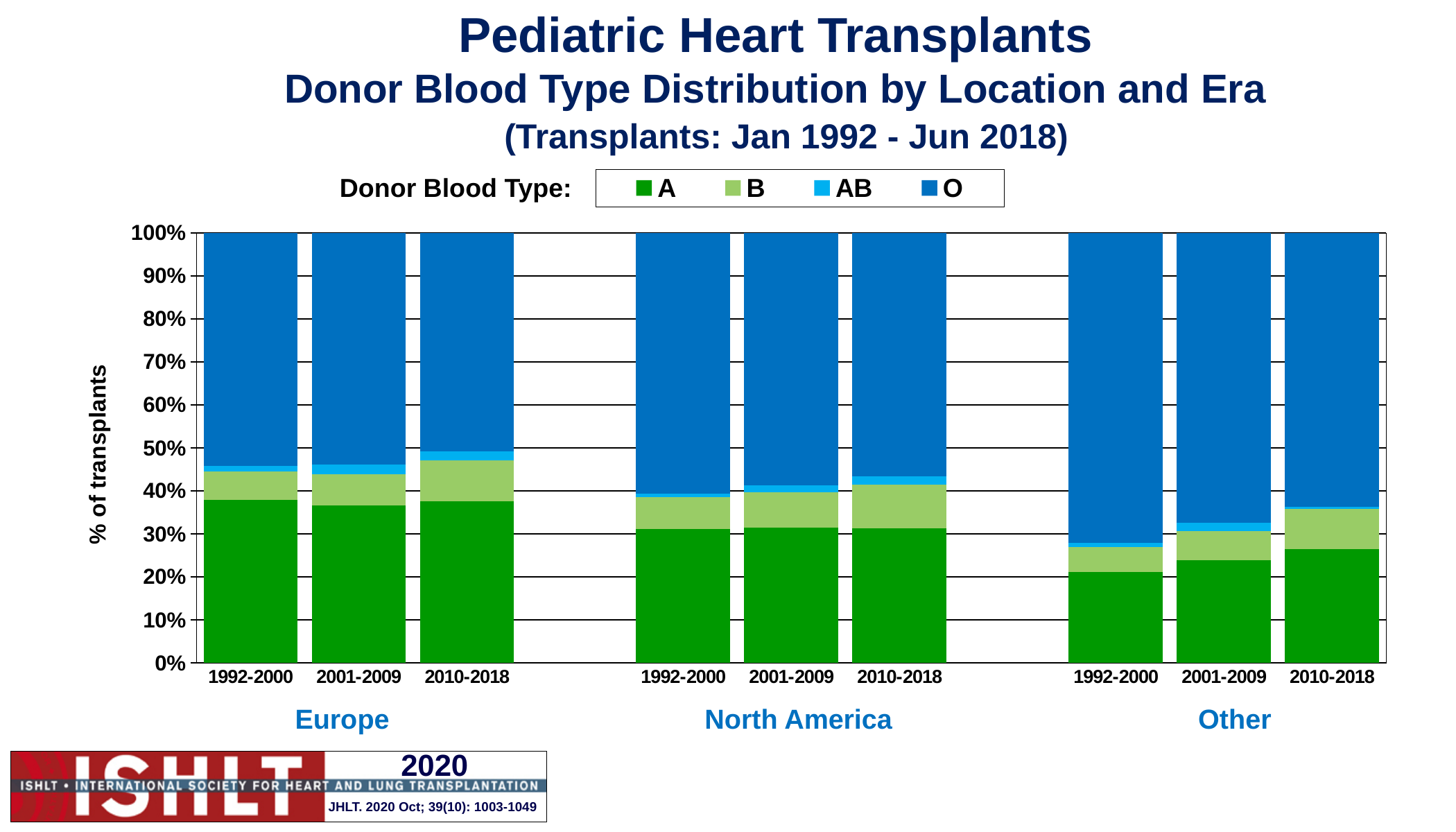
How many donor blood type series does the legend list? 4 How many bars are plotted in the chart in total? 9 Is the share of blood type A donors for North America in 2001-2009 greater or less than 40%? less For the Other location, does the share of blood type A donors rise or fall from 1992-2000 to 2010-2018? rise Which has the larger share of blood type A donors in 1992-2000: Europe or Other? Europe What kind of chart is shown on the slide? Stacked bar chart What is the title of the y axis? % of transplants Which location has the smallest share of blood type A donors in 2010-2018? Other Is the share of blood type A donors for Other in 1992-2000 greater or less than 30%? less Which location has the largest share of blood type O donors in 1992-2000? Other Is the share of blood type A donors for Europe in 1992-2000 greater or less than 30%? greater Which colour represents blood type O in the legend? Blue